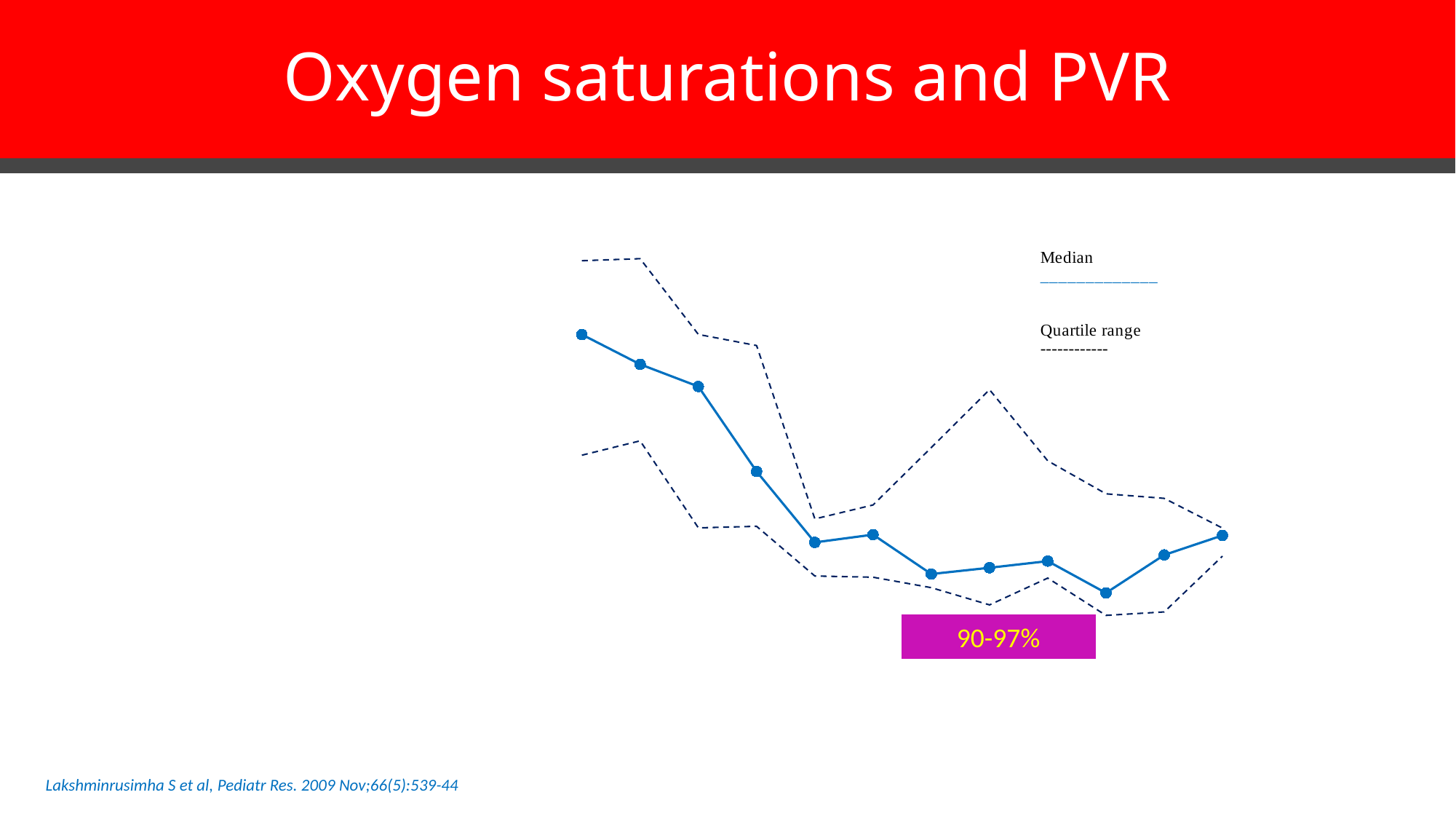
Is the first (leftmost) point of the Median line higher or lower than the last (rightmost) point? Higher Does the Median line overall rise or fall from left to right? Fall What are the two entries in the chart's legend? Median and Quartile range What kind of chart is shown on the slide? Line chart How many data points are plotted on the solid Median line? 12 How many entries does the chart's legend list? 2 What percentage range is printed in the highlighted box below the chart? 90-97% Which line style is used for the Quartile range in the chart? Dashed What is the title of the slide containing the chart? Oxygen saturations and PVR